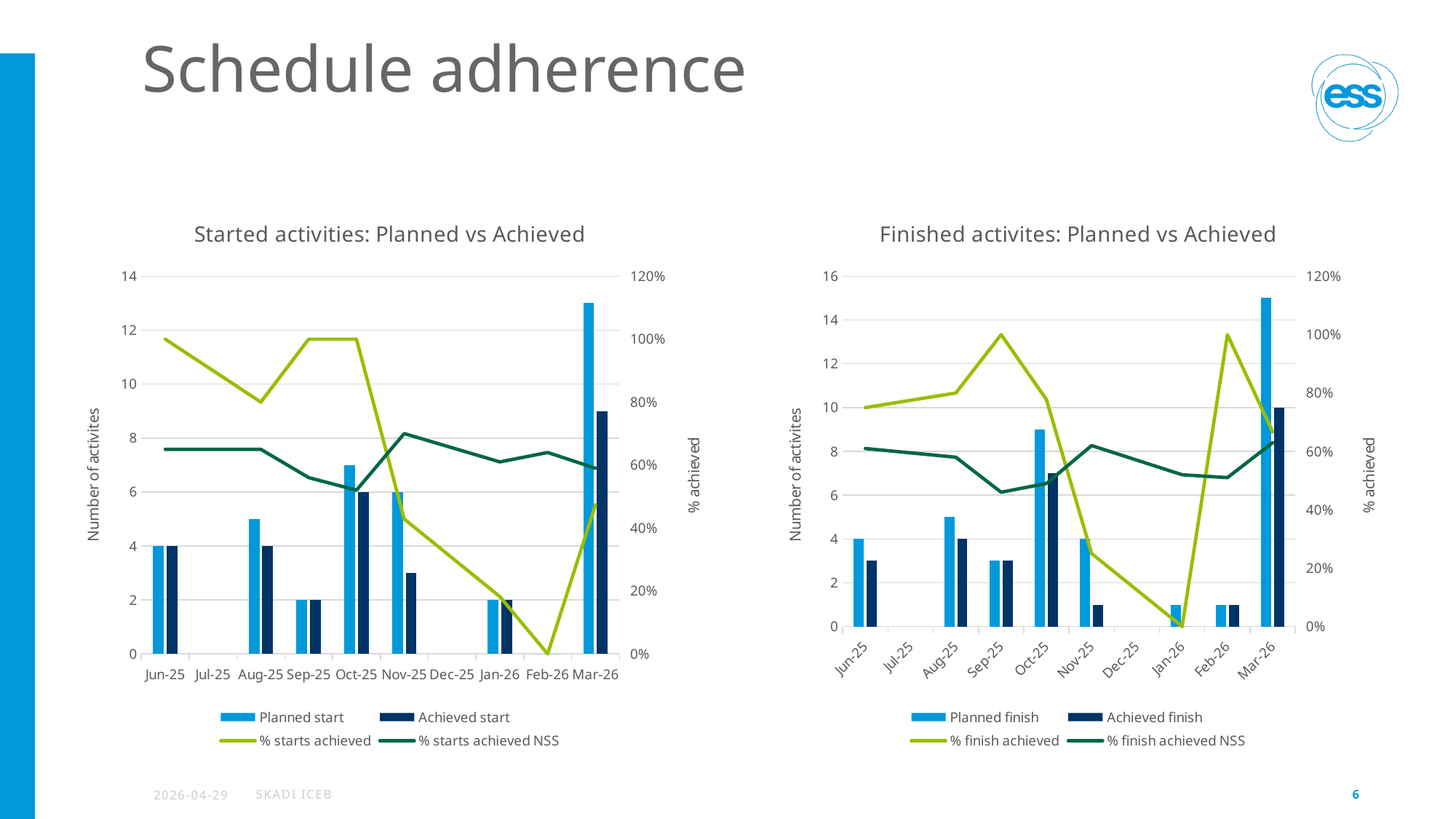
In the 'Started activities: Planned vs Achieved' chart, how many series does the legend list? 4 In the 'Finished activites: Planned vs Achieved' chart, what is the Achieved finish value for Mar-26? 10 In the 'Started activities: Planned vs Achieved' chart, what is the Planned start value for Jun-25? 4 In the 'Finished activites: Planned vs Achieved' chart, is the Planned finish value for Mar-26 greater or less than 14? greater In the 'Started activities: Planned vs Achieved' chart, what is the Achieved start value for Oct-25? 6 How many months are shown on the x axis of the 'Finished activites: Planned vs Achieved' chart? 10 In the 'Finished activites: Planned vs Achieved' chart, which month has the highest Planned finish value? Mar-26 In the 'Finished activites: Planned vs Achieved' chart, which is larger for Oct-25, Planned finish or Achieved finish? Planned finish In the 'Started activities: Planned vs Achieved' chart, which month has the highest Planned start value? Mar-26 In the 'Started activities: Planned vs Achieved' chart, is the Planned start value for Mar-26 greater or less than 12? greater In the 'Started activities: Planned vs Achieved' chart, does the '% starts achieved' line rise or fall from Oct-25 to Feb-26? fall In the 'Started activities: Planned vs Achieved' chart, what is the '% starts achieved' value for Feb-26? 0%